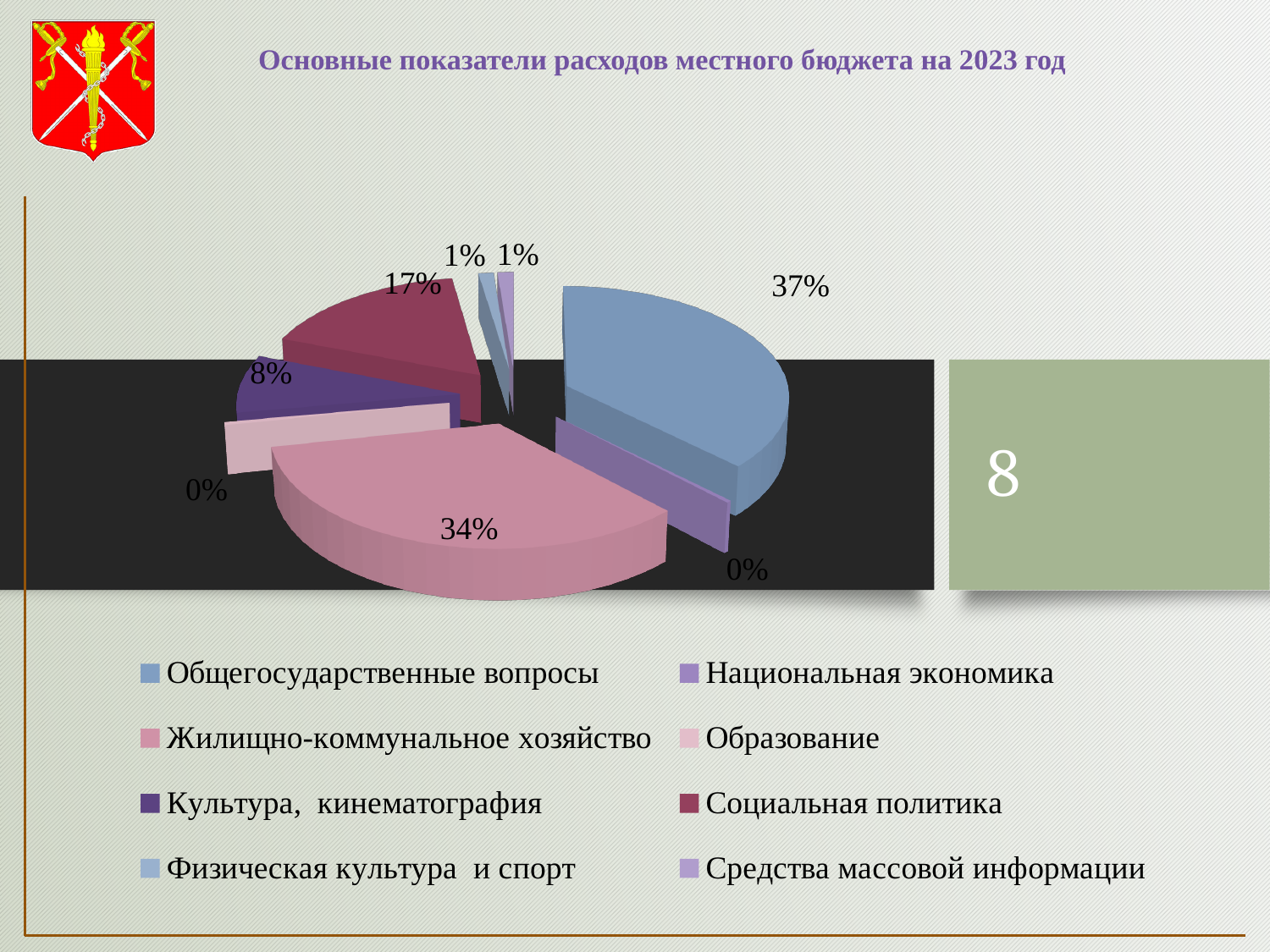
What is the difference in percentage points between Общегосударственные вопросы and Жилищно-коммунальное хозяйство? 3 percentage points What share of the pie does Физическая культура и спорт represent? 1% What kind of chart is shown on the slide? Pie chart Which is larger: the share for Социальная политика or the share for Культура, кинематография? Социальная политика What share of the pie does Культура, кинематография represent? 8% What share of the pie does Жилищно-коммунальное хозяйство represent? 34% What share of the pie does Социальная политика represent? 17% Which category has the largest share of the pie? Общегосударственные вопросы How many categories does the legend list? 8 What is the title of the slide? Основные показатели расходов местного бюджета на 2023 год What is the difference in percentage points between Социальная политика and Культура, кинематография? 9 percentage points What share of the pie does Общегосударственные вопросы represent? 37%